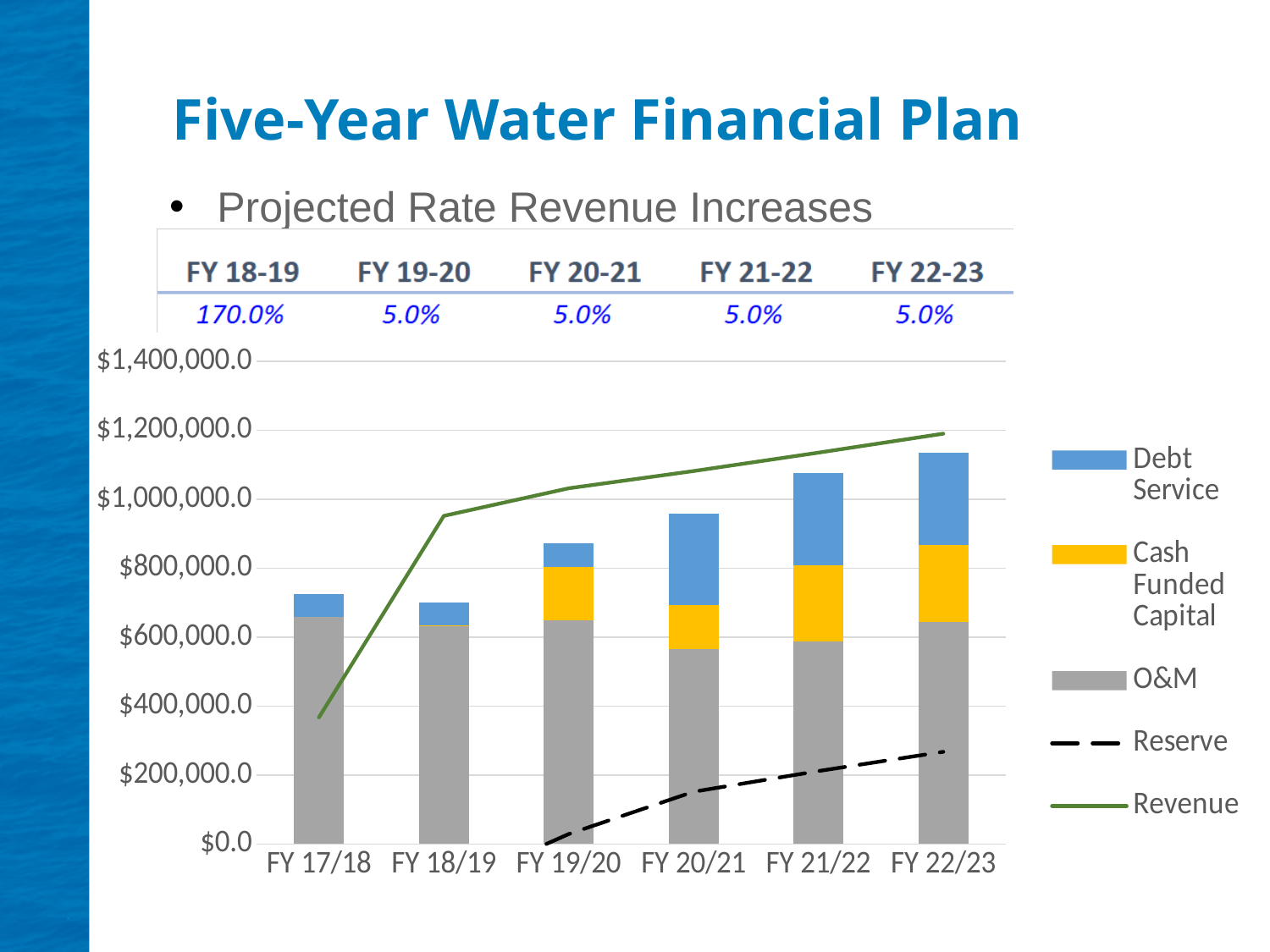
Does the Revenue line rise or fall from FY 17/18 to FY 22/23? rises Is the Reserve line value for FY 22/23 greater or less than $400,000.0? less Is the total height of the stacked bar for FY 18/19 greater or less than $800,000.0? less How many series does the chart legend list? 5 How many fiscal years are shown on the x axis of the chart? 6 What kind of chart is shown on the slide? bar chart (stacked bars with line series) Is the Revenue line value for FY 17/18 greater or less than $600,000.0? less Which series is shown as a dashed line in the chart? Reserve Which fiscal year has the tallest stacked bar? FY 22/23 Is the total stacked bar for FY 22/23 larger or smaller than the total stacked bar for FY 17/18? larger Which series is shown in gray in the stacked bars? O&M